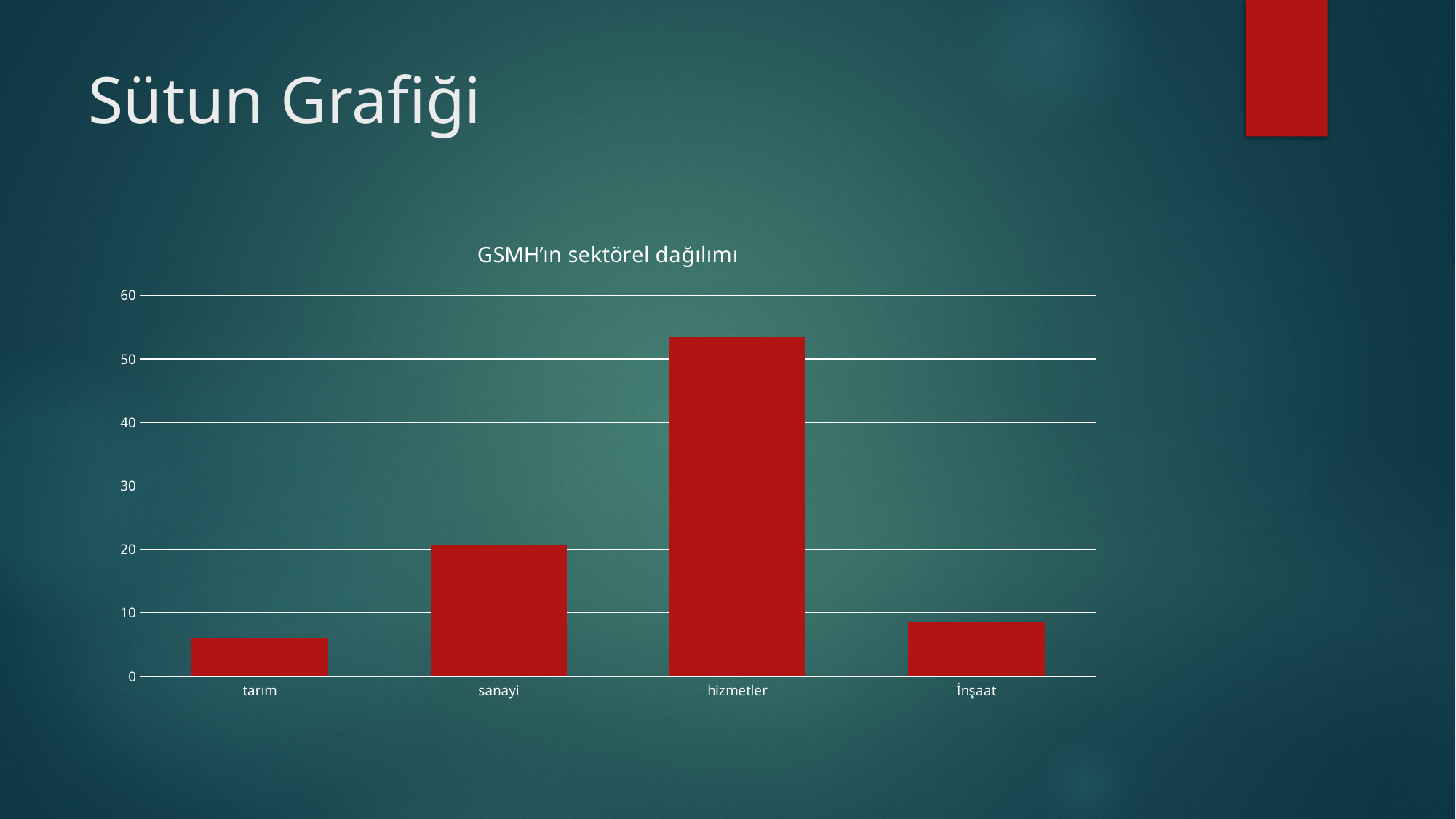
What is the title of the chart? GSMH’ın sektörel dağılımı How many categories are shown on the x axis of the chart? 4 Which category has the highest value in the chart? hizmetler Is the value for İnşaat greater or less than 10? less Is the value for tarım greater or less than 10? less What is the highest value shown on the vertical axis of the chart? 60 What kind of chart is shown on the slide? bar chart Is the value for sanayi greater or less than 30? less Which category has the lowest value in the chart? tarım Which is larger, the value for sanayi or the value for İnşaat? sanayi Which is larger, the value for tarım or the value for İnşaat? İnşaat